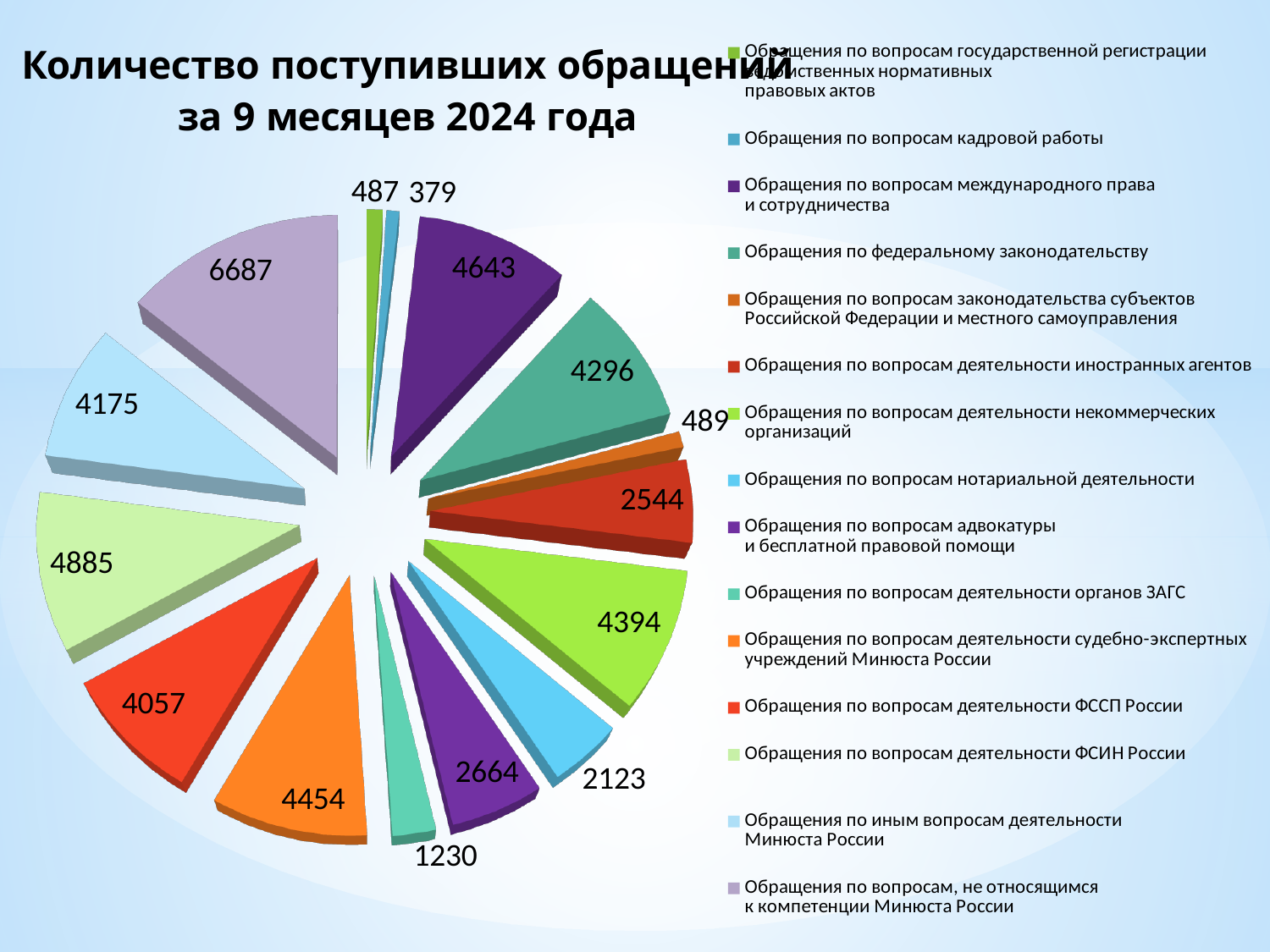
Which category has the largest value? Обращения по вопросам, не относящимся к компетенции Минюста России What is the title of the chart? Количество поступивших обращений за 9 месяцев 2024 года What is the value for "Обращения по вопросам деятельности ФСИН России"? 4885 What is the difference between the values for "Обращения по вопросам, не относящимся к компетенции Минюста России" and "Обращения по вопросам деятельности ФСИН России"? 1802 What kind of chart is shown on the slide? Pie chart Which category has the smallest value? Обращения по вопросам кадровой работы What is the value for "Обращения по вопросам деятельности органов ЗАГС"? 1230 Which is larger: the value for "Обращения по вопросам международного права и сотрудничества" or for "Обращения по федеральному законодательству"? Обращения по вопросам международного права и сотрудничества What is the value for "Обращения по вопросам кадровой работы"? 379 How many categories does the legend list? 15 What is the value for "Обращения по вопросам, не относящимся к компетенции Минюста России"? 6687 What is the difference between the values for "Обращения по вопросам адвокатуры и бесплатной правовой помощи" and "Обращения по вопросам нотариальной деятельности"? 541